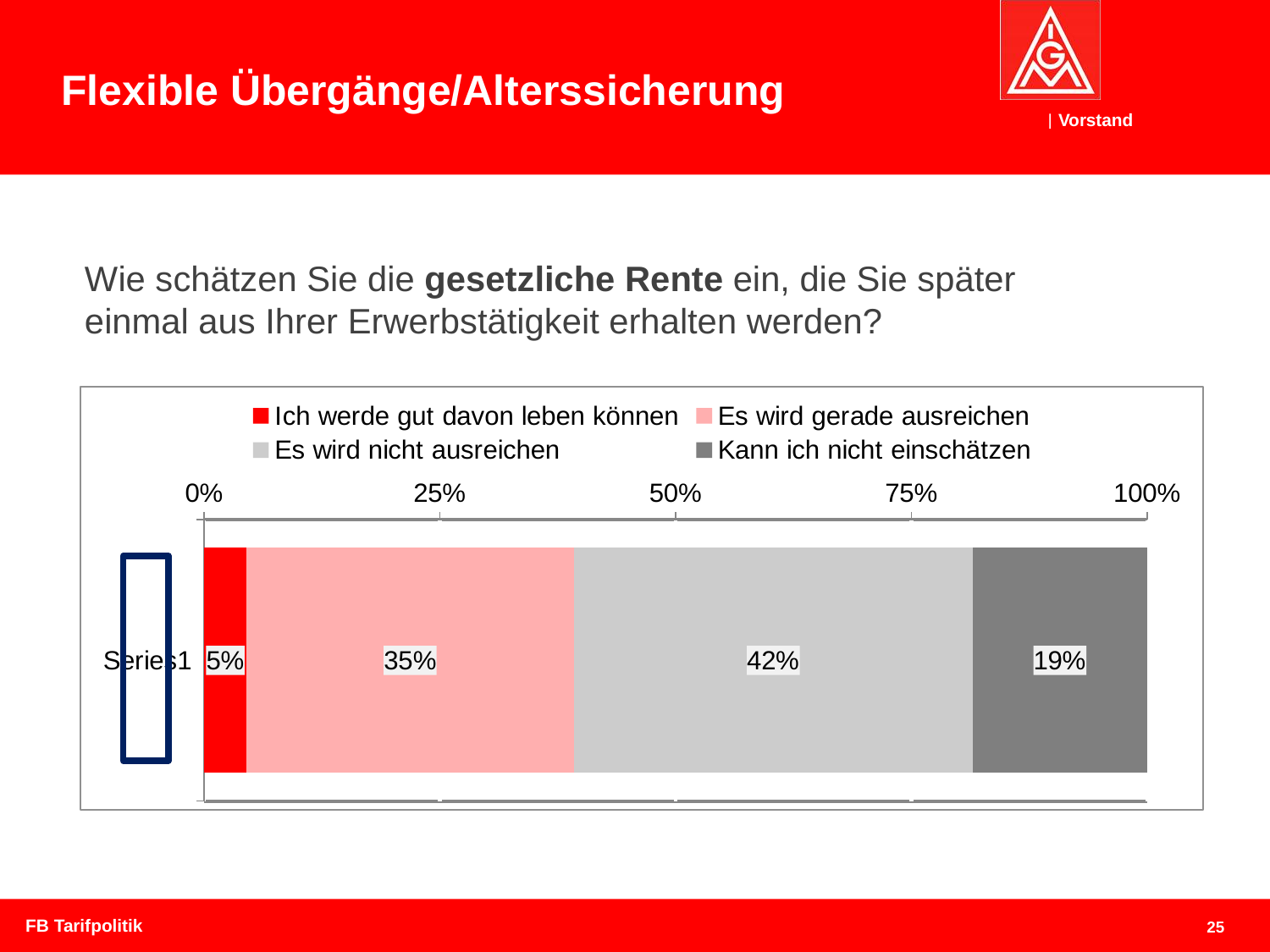
Which response has the highest share? Es wird nicht ausreichen What colour is the segment for "Ich werde gut davon leben können"? red What is the value for "Kann ich nicht einschätzen"? 19% Which response has the lowest share? Ich werde gut davon leben können How many series does the legend list? 4 What kind of chart is shown on the slide? stacked bar chart What is the value for "Ich werde gut davon leben können"? 5% What is the difference between "Es wird nicht ausreichen" and "Es wird gerade ausreichen"? 7% What is the total of the stacked bar? 101% What is the value for "Es wird gerade ausreichen"? 35% Which is larger, "Kann ich nicht einschätzen" or "Es wird gerade ausreichen"? Es wird gerade ausreichen What is the value for "Es wird nicht ausreichen"? 42%